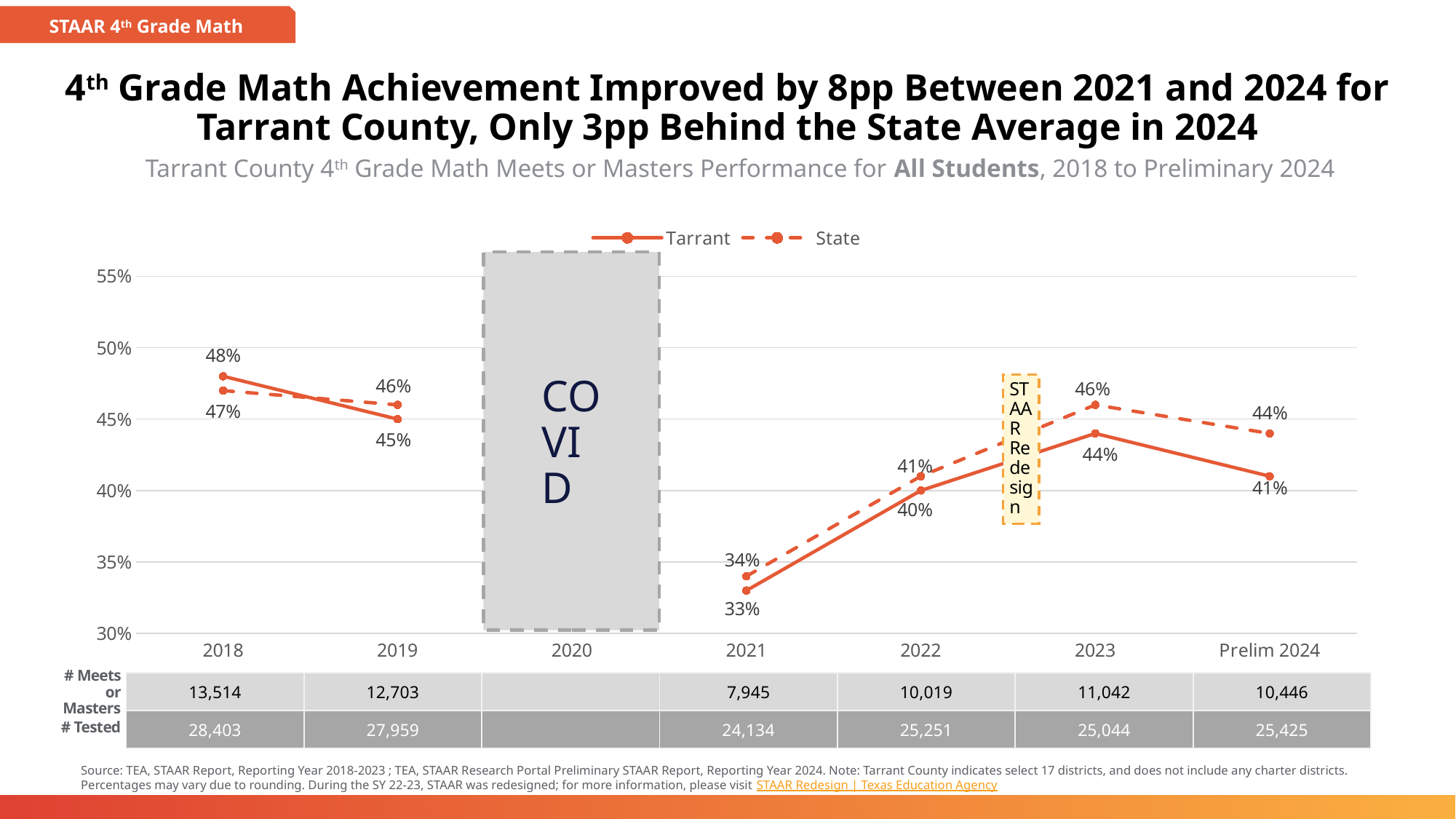
What was the State value in Prelim 2024? 44% In which year was the Tarrant value lowest? 2021 Which year on the x axis has no data plotted because of COVID? 2020 What was the Tarrant value in 2021? 33% What is the difference between the State and Tarrant values in Prelim 2024? 3pp According to the table, how many students were tested in 2021? 24,134 What was the Tarrant value in 2018? 48% In which year was the Tarrant value highest? 2018 Which was larger in 2018, the Tarrant value or the State value? Tarrant Did the Tarrant value rise or fall between 2021 and 2023? Rise How many series does the legend list? 2 What kind of chart is shown on the slide? Line chart